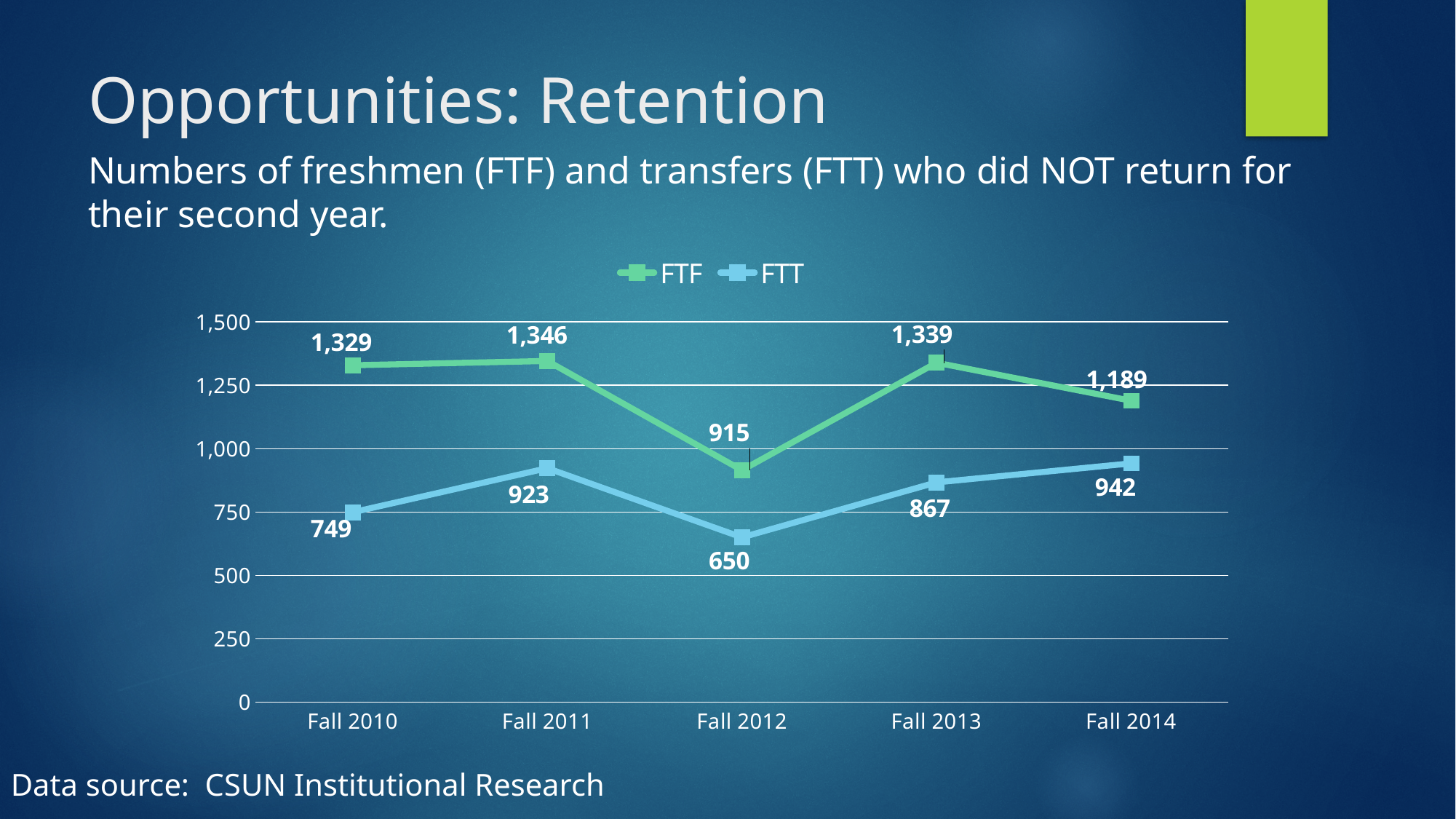
What is the FTT value for Fall 2010? 749 What is the FTF value for Fall 2012? 915 What is the FTT value for Fall 2014? 942 Is the FTF value for Fall 2014 greater or less than 1,000? greater What kind of chart is shown on the slide? line chart In which year is the FTT series lowest? Fall 2012 What is the difference between the FTF and FTT values in Fall 2013? 472 In which year is the FTF series highest? Fall 2011 How many series does the legend list? 2 How many years are shown on the x axis? 5 Does the FTT series rise or fall from Fall 2012 to Fall 2014? rise Which is larger in Fall 2012, the FTF value or the FTT value? FTF